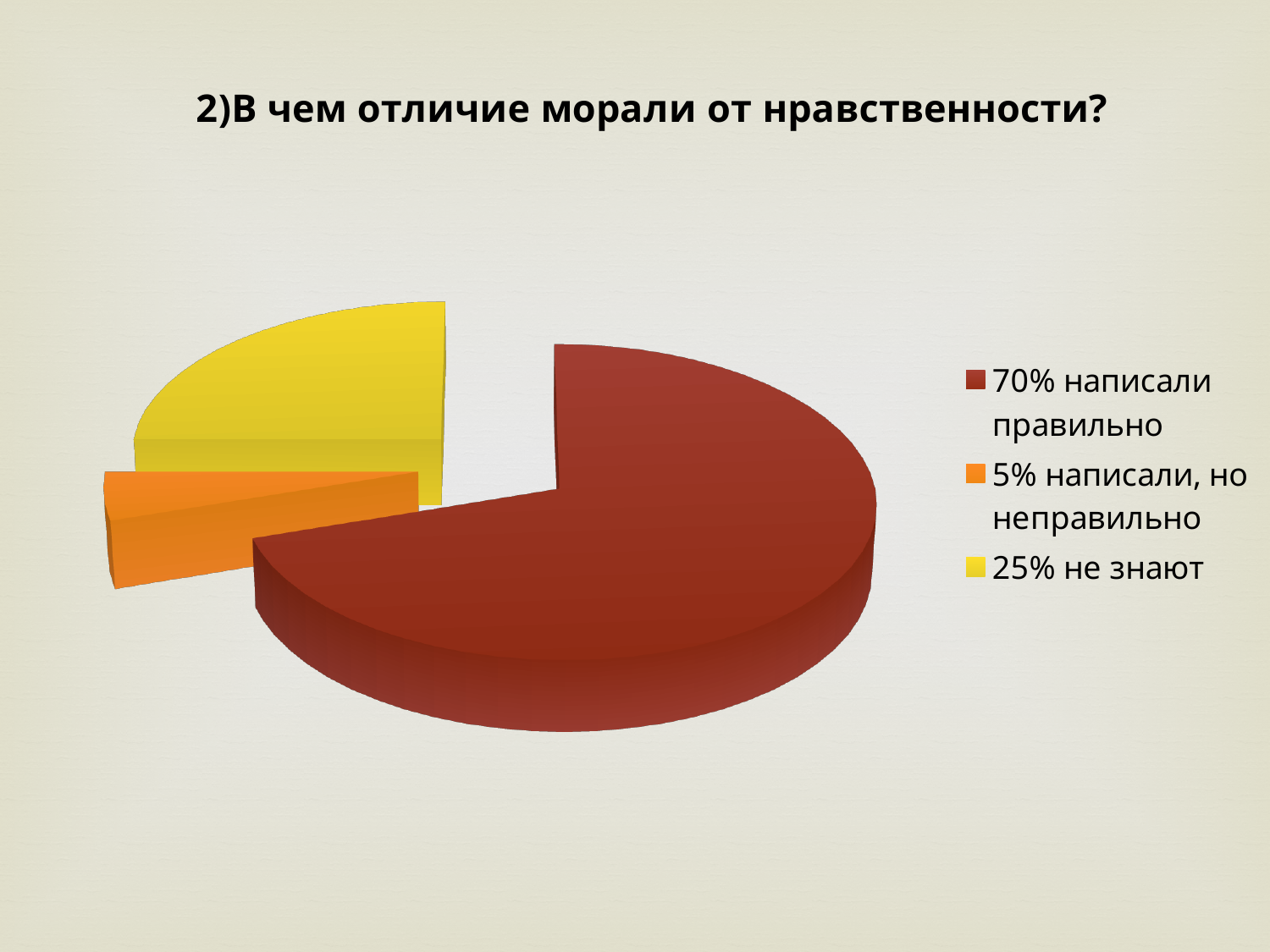
Which category has the smallest share of the pie? 5% написали, но неправильно What colour is the slice for 'не знают'? yellow What percentage of respondents wrote the answer correctly (написали правильно)? 70% What percentage of respondents do not know (не знают)? 25% How many slices does the pie chart have? 3 What kind of chart is shown on the slide? pie chart What is the combined share of those who wrote incorrectly and those who do not know? 30% What is the difference in percentage points between those who wrote correctly and those who do not know? 45 What is the title of the chart? 2)В чем отличие морали от нравственности? What percentage of respondents wrote an answer but incorrectly (написали, но неправильно)? 5% Which category has the largest share of the pie? 70% написали правильно Which is larger: the share of those who do not know or the share of those who wrote incorrectly? не знают (25%)